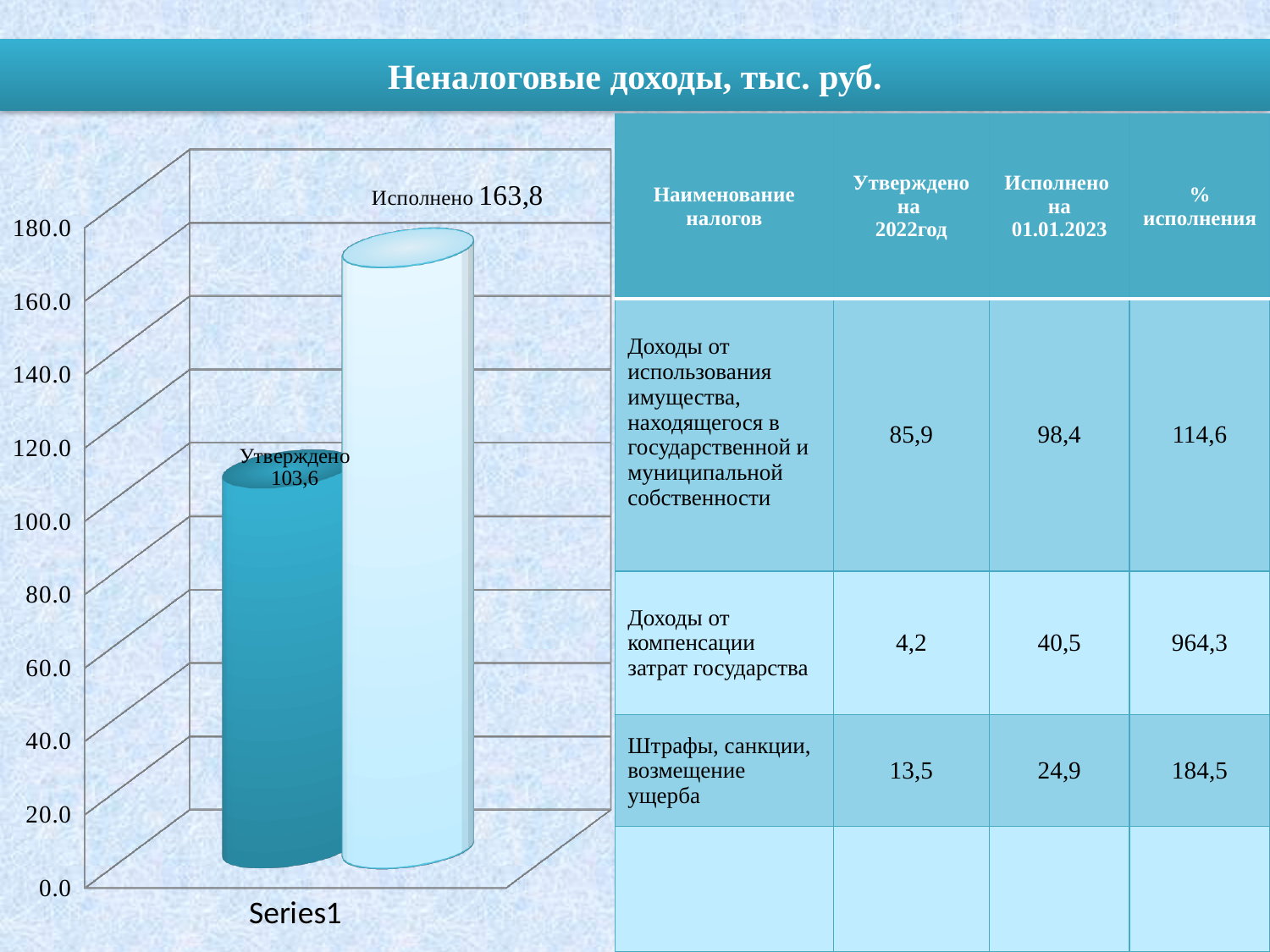
What kind of chart is shown on the slide? bar chart What is the difference between the "Исполнено" value and the "Утверждено" value? 60,2 What is the value of the bar labelled "Утверждено"? 103,6 Which bar has the highest value? Исполнено Is the value for "Утверждено" greater or less than 120.0? less Which bar has the lowest value? Утверждено How many bars are plotted in the chart? 2 Which bar is taller, "Утверждено" or "Исполнено"? Исполнено What is the label shown on the horizontal axis of the chart? Series1 Is the value for "Исполнено" greater or less than 140.0? greater What is the highest value shown on the vertical axis of the chart? 180.0 What is the value of the bar labelled "Исполнено"? 163,8